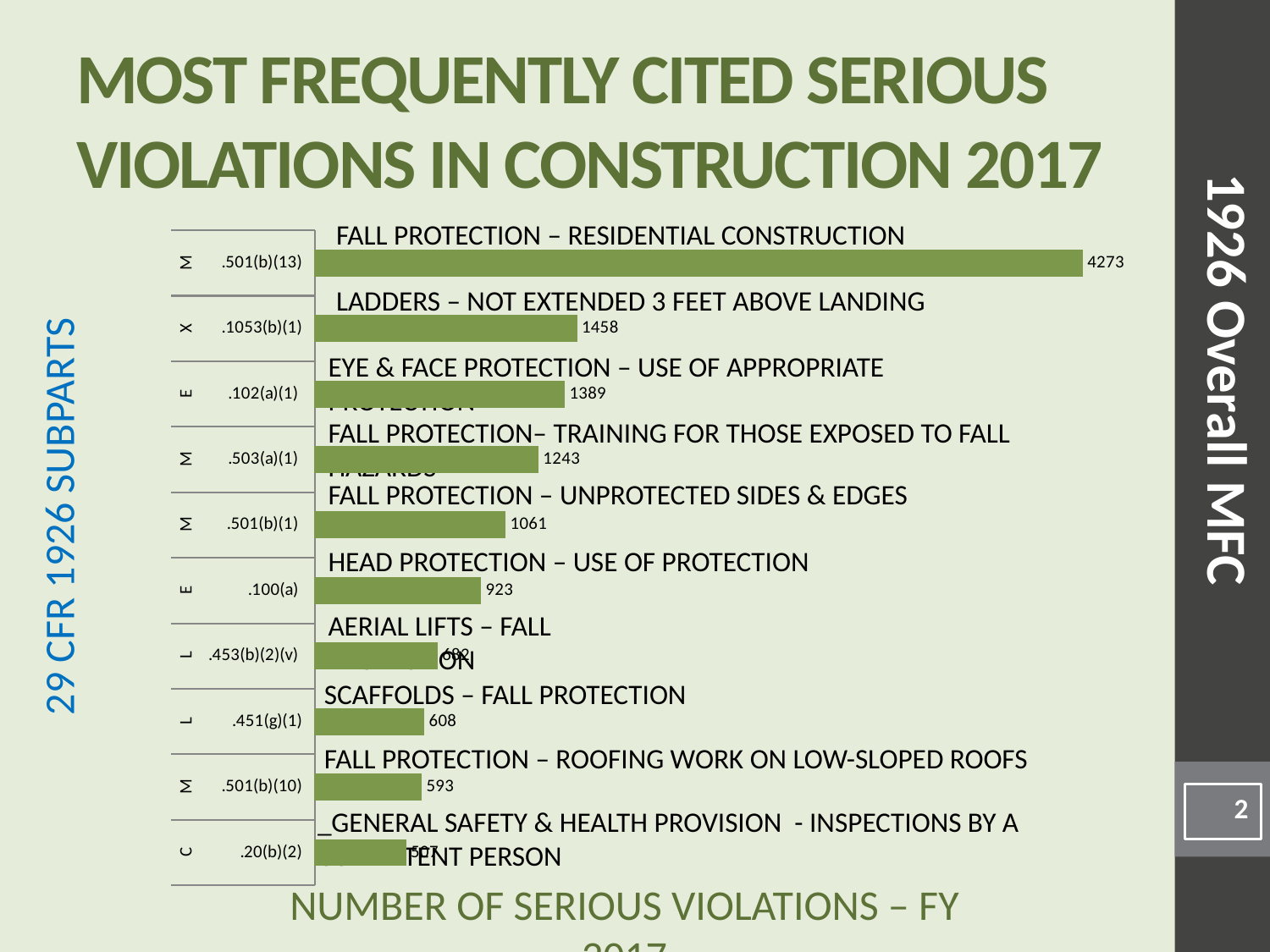
What is the number of serious violations for .1053(b)(1), Ladders – Not Extended 3 Feet Above Landing? 1458 What type of chart is shown on the slide? bar chart What is the value shown for .102(a)(1), Eye & Face Protection? 1389 What is the number of serious violations for .501(b)(13), Fall Protection – Residential Construction? 4273 What is the difference between the values for .451(g)(1) and .501(b)(10)? 15 Which has more serious violations, .501(b)(1) or .451(g)(1)? .501(b)(1) Which standard has the highest number of serious violations? .501(b)(13) What is the value shown for .503(a)(1), Fall Protection – Training? 1243 What is the difference between the violations for .501(b)(13) and .1053(b)(1)? 2815 What is the title of the chart's horizontal axis? NUMBER OF SERIOUS VIOLATIONS – FY 2017 What is the value shown for .100(a), Head Protection – Use of Protection? 923 How many categories (standards) are plotted in the chart? 10